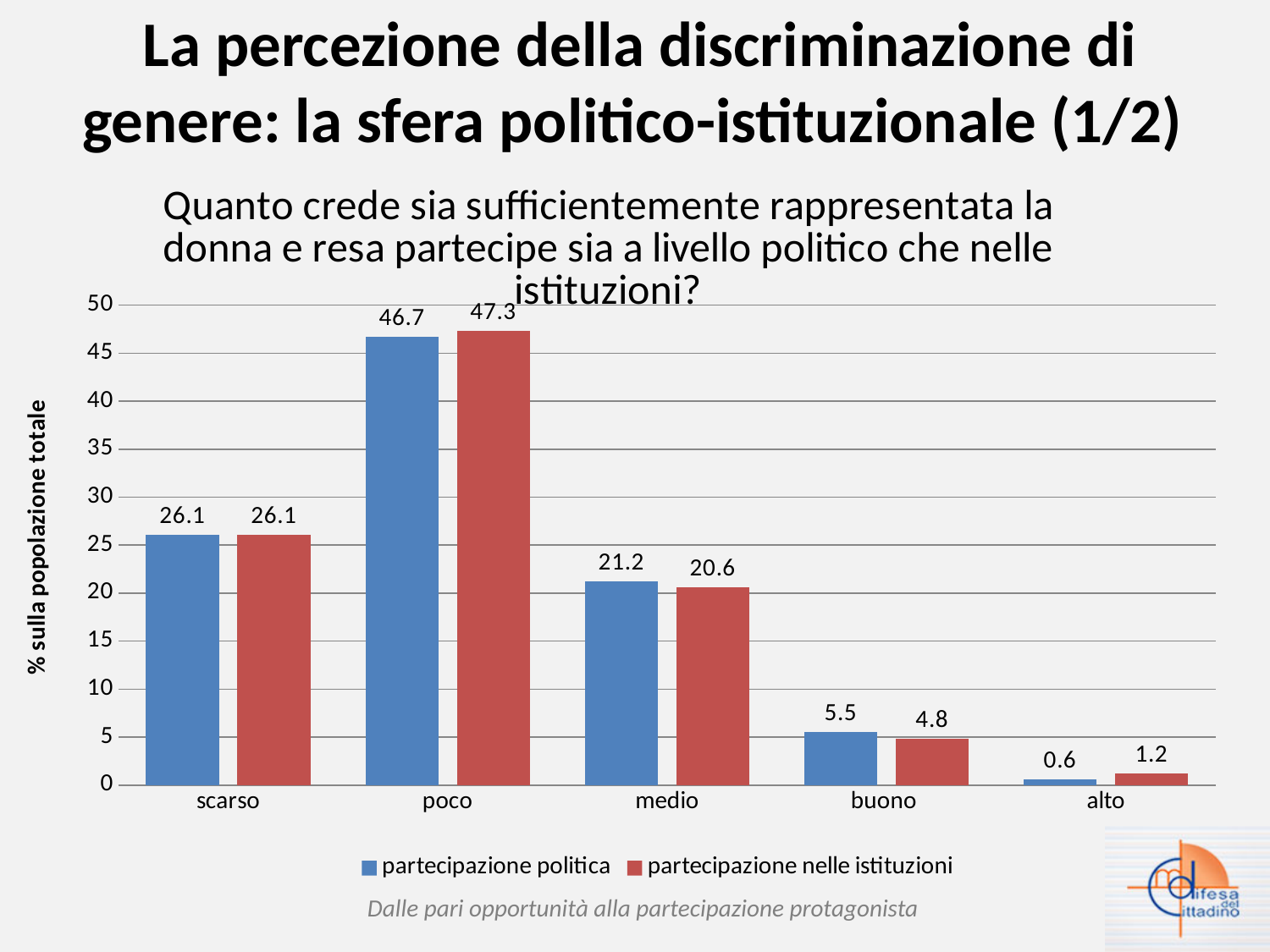
What is the value for 'partecipazione politica' in the 'alto' category? 0.6 Which category has the lowest value for 'partecipazione politica'? alto Which category has the highest value for 'partecipazione nelle istituzioni'? poco In the 'alto' category, which series has the larger value: 'partecipazione politica' or 'partecipazione nelle istituzioni'? partecipazione nelle istituzioni What is the value for 'partecipazione politica' in the 'poco' category? 46.7 How many series does the legend list? 2 What is the value for 'partecipazione nelle istituzioni' in the 'medio' category? 20.6 Is the value for 'partecipazione politica' in the 'scarso' category greater or less than 25? greater How many categories are shown on the x axis? 5 What is the difference between 'partecipazione politica' and 'partecipazione nelle istituzioni' in the 'buono' category? 0.7 What kind of chart is shown on the slide? bar chart What is the label of the y axis? % sulla popolazione totale